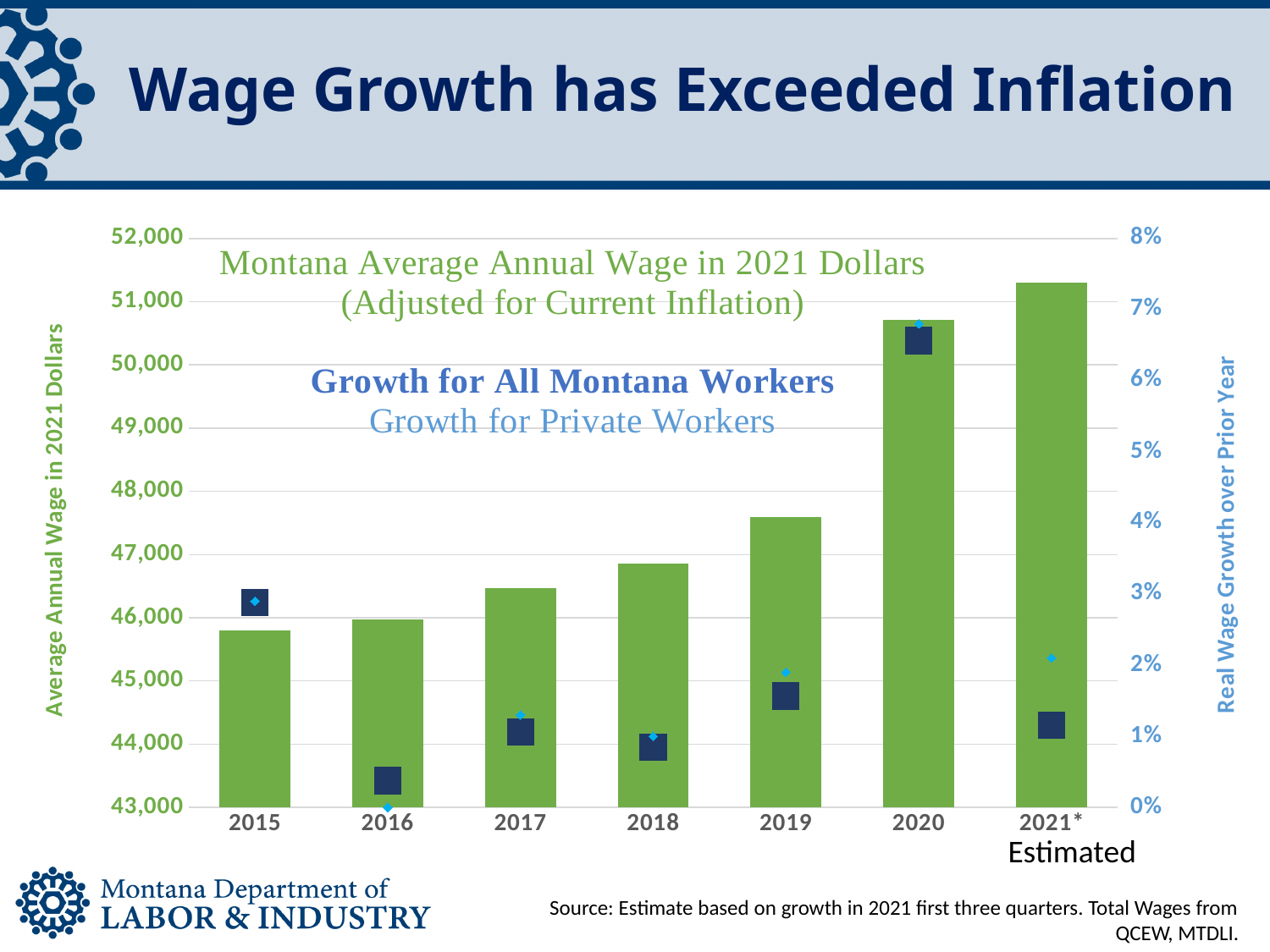
What is the title of the right-hand vertical axis? Real Wage Growth over Prior Year Which year has the lowest Growth for All Montana Workers marker? 2016 Which year has the highest Growth for All Montana Workers marker? 2020 Which year has the larger Montana Average Annual Wage in 2021 Dollars bar, 2019 or 2020? 2020 Is the Montana Average Annual Wage in 2021 Dollars bar for 2019 greater or less than 48,000? less Is the Growth for All Montana Workers value for 2016 greater or less than 1%? less Do the Montana Average Annual Wage in 2021 Dollars bars generally rise or fall from 2015 to 2021*? rise Is the Montana Average Annual Wage in 2021 Dollars bar for 2020 greater or less than 50,000? greater How many years are shown on the x axis of the chart? 7 What kind of chart is shown on the slide? Bar chart with overlaid markers (combo chart) Which year has the highest Montana Average Annual Wage in 2021 Dollars bar? 2021* How many series does the chart's legend list? 3